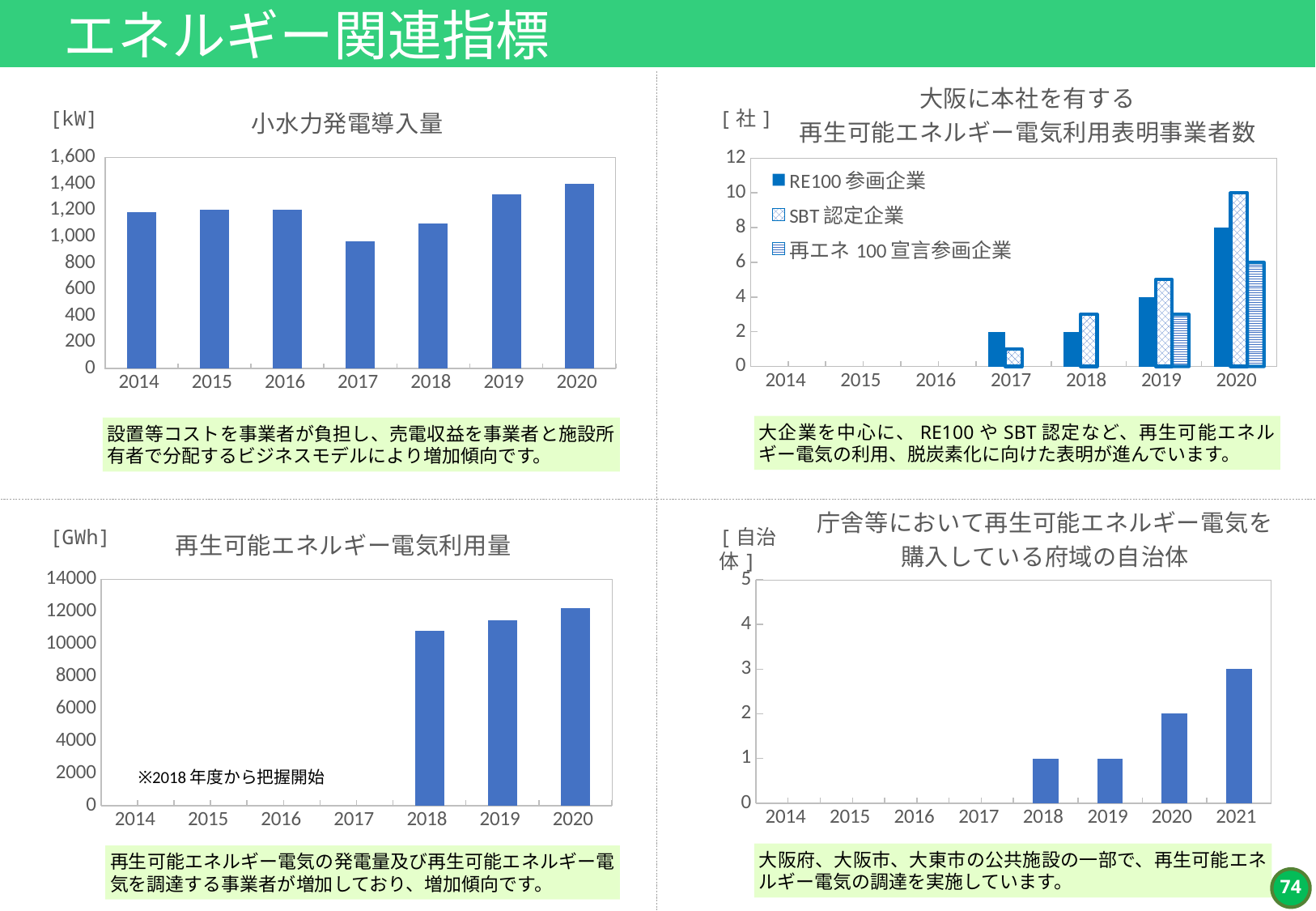
In the top-right chart (大阪に本社を有する再生可能エネルギー電気利用表明事業者数), what is the value for RE100参画企業 in 2020? 8 In the 小水力発電導入量 chart (top left), is the value for 2017 greater or less than 1,000? less In the top-right chart (大阪に本社を有する再生可能エネルギー電気利用表明事業者数), which series has the larger value in 2020, RE100参画企業 or 再エネ100宣言参画企業? RE100参画企業 In the 小水力発電導入量 chart (top left), which year has the lowest value? 2017 In the top-right chart (大阪に本社を有する再生可能エネルギー電気利用表明事業者数), what is the value for SBT認定企業 in 2020? 10 In the 再生可能エネルギー電気利用量 chart (bottom left), is the value for 2018 greater or less than 10000? greater In the 小水力発電導入量 chart (top left), which year has the highest value? 2020 In the bottom-right chart (庁舎等において再生可能エネルギー電気を購入している府域の自治体), what is the value for 2021? 3 In the top-right chart (大阪に本社を有する再生可能エネルギー電気利用表明事業者数), how many series does the legend list? 3 In the 小水力発電導入量 chart (top left), how many years are plotted? 7 In the bottom-right chart (庁舎等において再生可能エネルギー電気を購入している府域の自治体), what is the difference between the values for 2021 and 2018? 2 In the 再生可能エネルギー電気利用量 chart (bottom left), how many years have a bar plotted? 3